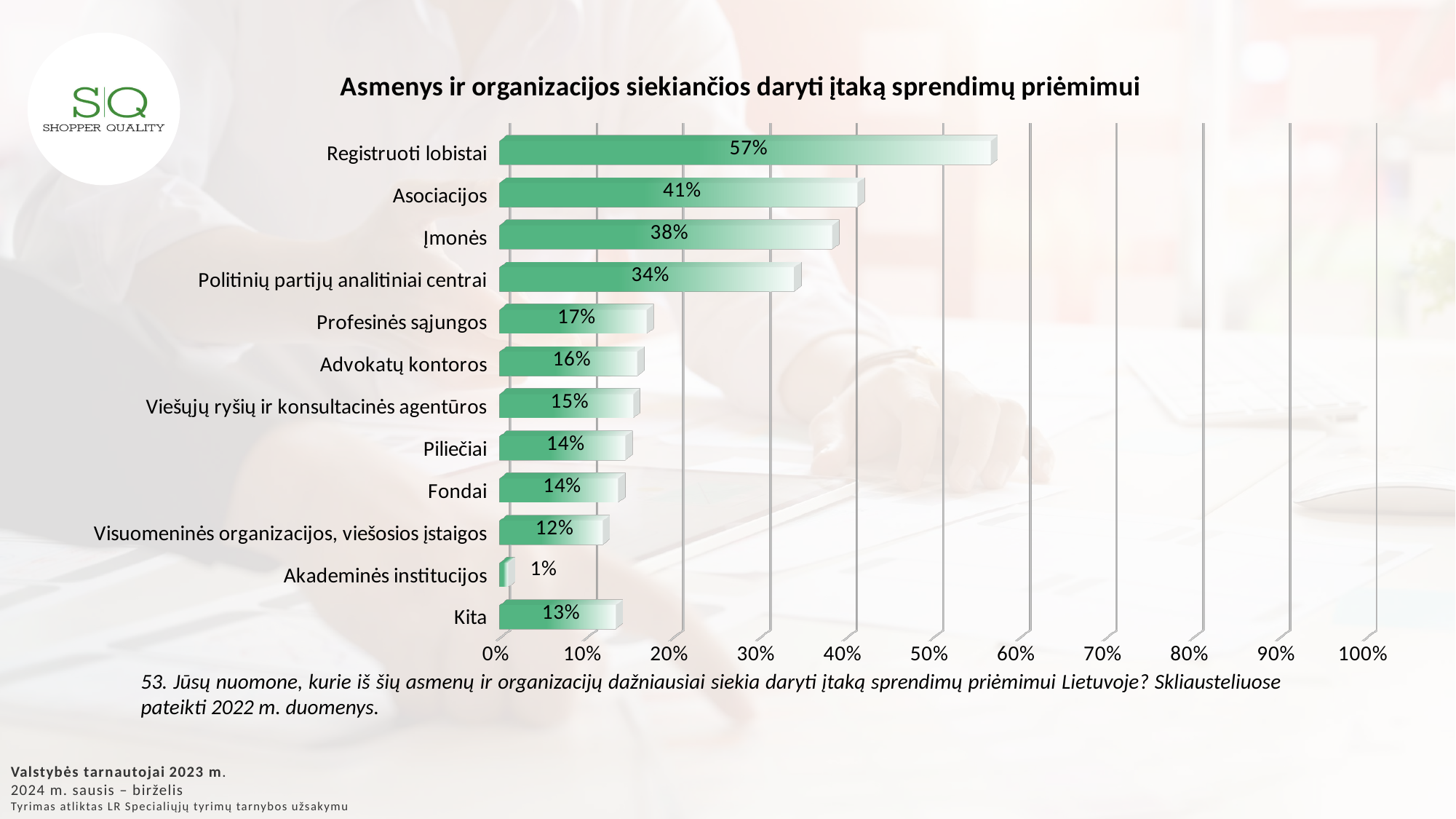
What is the value for Akademinės institucijos? 1% Which is larger, the value for Profesinės sąjungos or the value for Advokatų kontoros? Profesinės sąjungos What is the title of the chart? Asmenys ir organizacijos siekiančios daryti įtaką sprendimų priėmimui How many categories are shown in the chart? 12 What is the value for Politinių partijų analitiniai centrai? 34% What is the difference between the values for Asociacijos and Įmonės? 3% What is the value for Registruoti lobistai? 57% Which category has the lowest value? Akademinės institucijos Which category has the highest value? Registruoti lobistai Is the value for Registruoti lobistai greater or less than 50%? greater What is the value for Kita? 13% What kind of chart is shown on the slide? bar chart